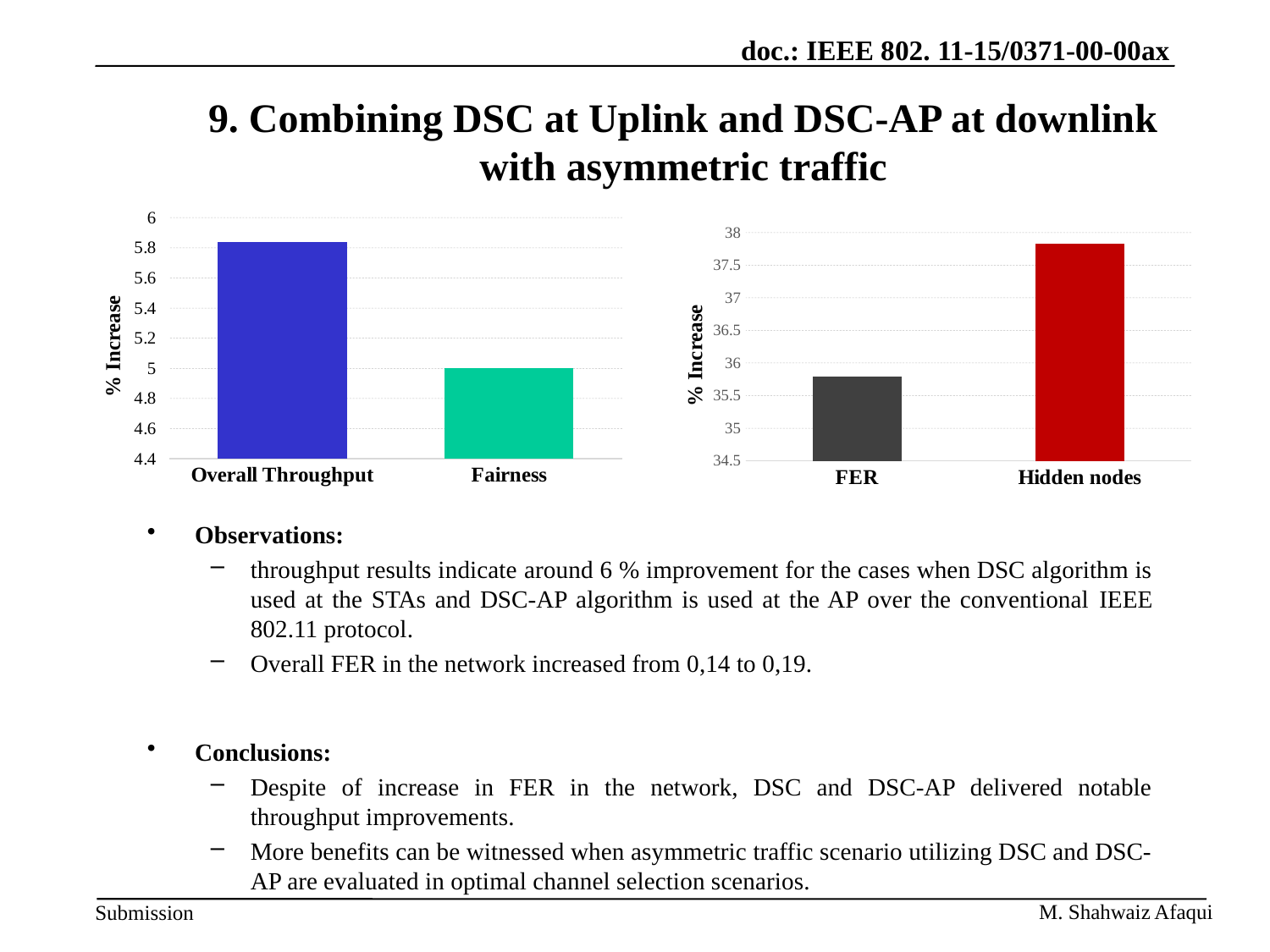
What is the y-axis title of the left chart? % Increase In the right chart, what colour is the Hidden nodes bar? red In the right chart, how many categories are plotted? 2 In the right chart, is the value for FER greater or less than 36? less What kind of chart is the right chart with FER and Hidden nodes? bar chart In the right chart, which category has the lower value? FER In the left chart, which category has the higher value? Overall Throughput In the left chart, how many categories are plotted? 2 What kind of chart is the left chart with Overall Throughput and Fairness? bar chart In the left chart, is the value for Overall Throughput greater or less than 5.6? greater In the right chart, is the value for Hidden nodes greater or less than 37.5? greater In the right chart, which is larger, the value for Hidden nodes or the value for FER? Hidden nodes